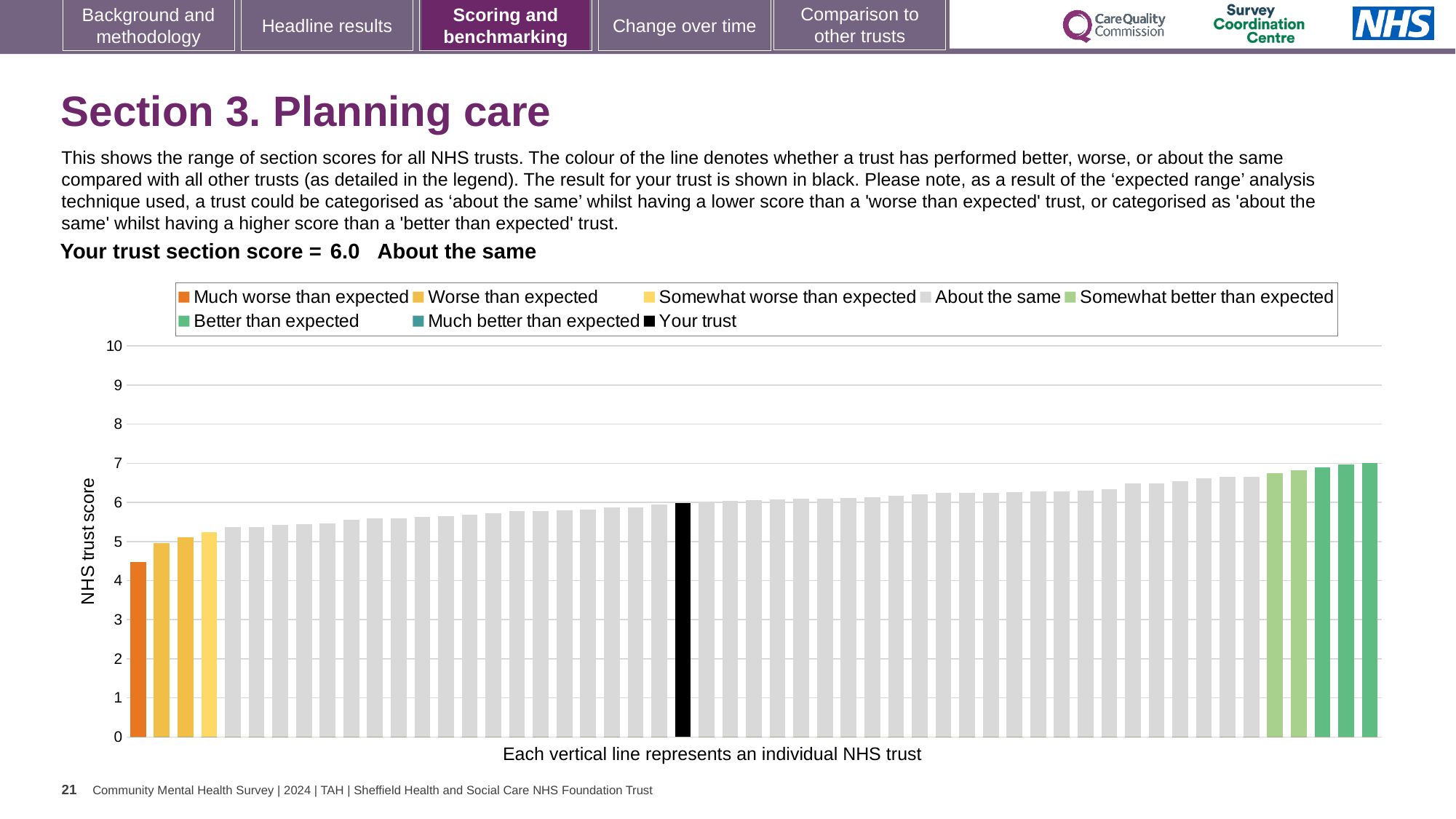
What kind of chart is shown on the slide? bar chart Is the value of the lowest (orange) bar greater or less than 5? less What is the section score for your trust? 6.0 What colour is the bar representing your trust? black Is the black bar for your trust higher or lower than the orange bar? higher Is the value of the lowest (orange) bar greater or less than 4? greater Is the value of the highest bar on the right greater or less than 6? greater How many entries does the chart legend list? 8 What is the label on the vertical axis of the chart? NHS trust score Which performance category is your trust placed in for this section? About the same Do the bar values rise or fall from left to right across the chart? rise How many black bars are there in the chart? 1